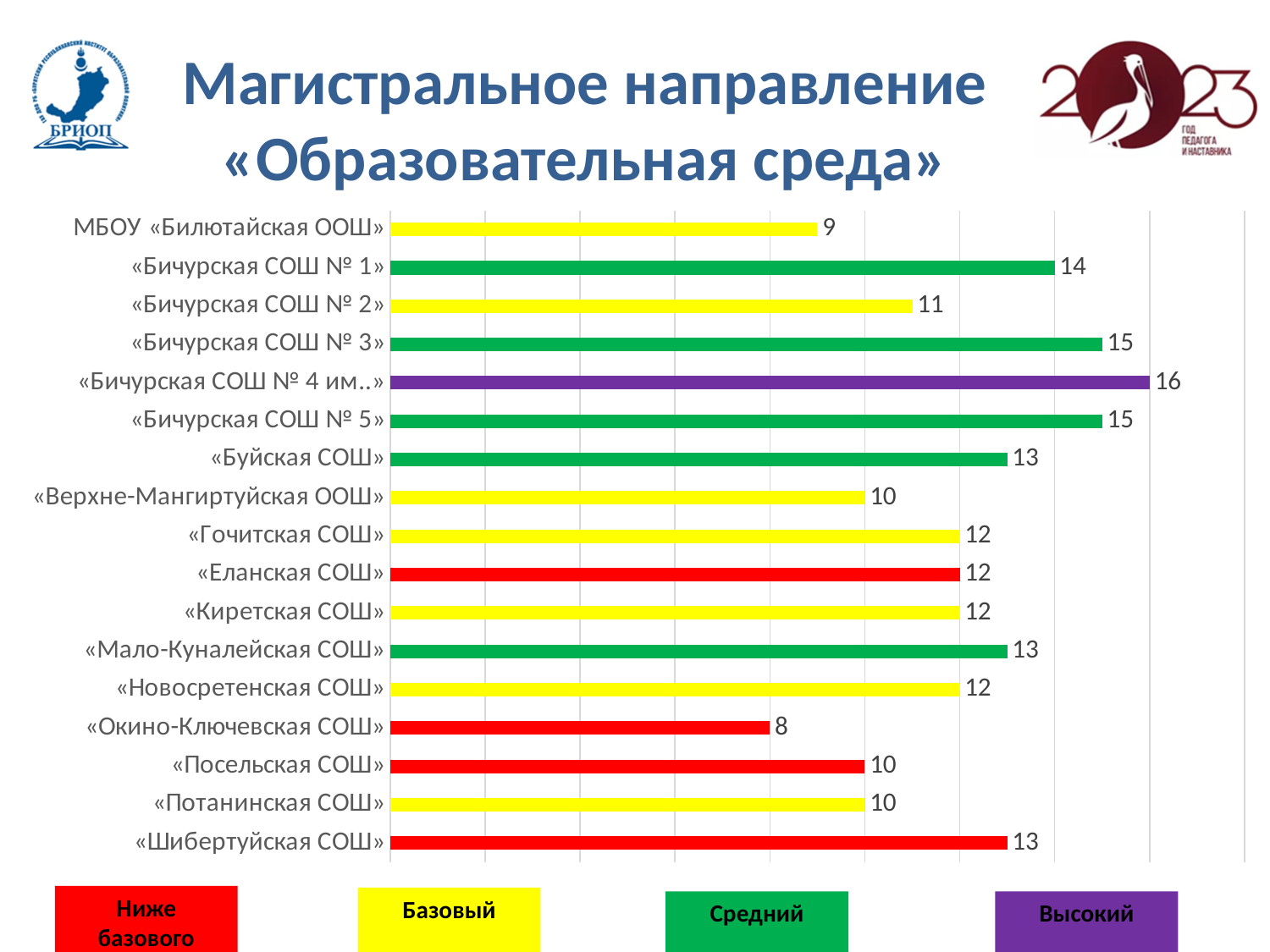
How many schools are shown in the chart? 17 What is the difference between the values for «Шибертуйская СОШ» and «Посельская СОШ»? 3 What is the difference between the values for «Бичурская СОШ № 4 им..» and МБОУ «Билютайская ООШ»? 7 Which is larger, the value for «Бичурская СОШ № 2» or the value for «Буйская СОШ»? «Буйская СОШ» What is the value for «Верхне-Мангиртуйская ООШ»? 10 What is the value for «Бичурская СОШ № 1»? 14 What colour is the bar for «Бичурская СОШ № 4 им..»? Purple Which school has the highest value? «Бичурская СОШ № 4 им..» Which school has the lowest value? «Окино-Ключевская СОШ» What is the value for «Окино-Ключевская СОШ»? 8 According to the legend, what level does the red colour represent? Ниже базового What kind of chart is shown on the slide? Bar chart